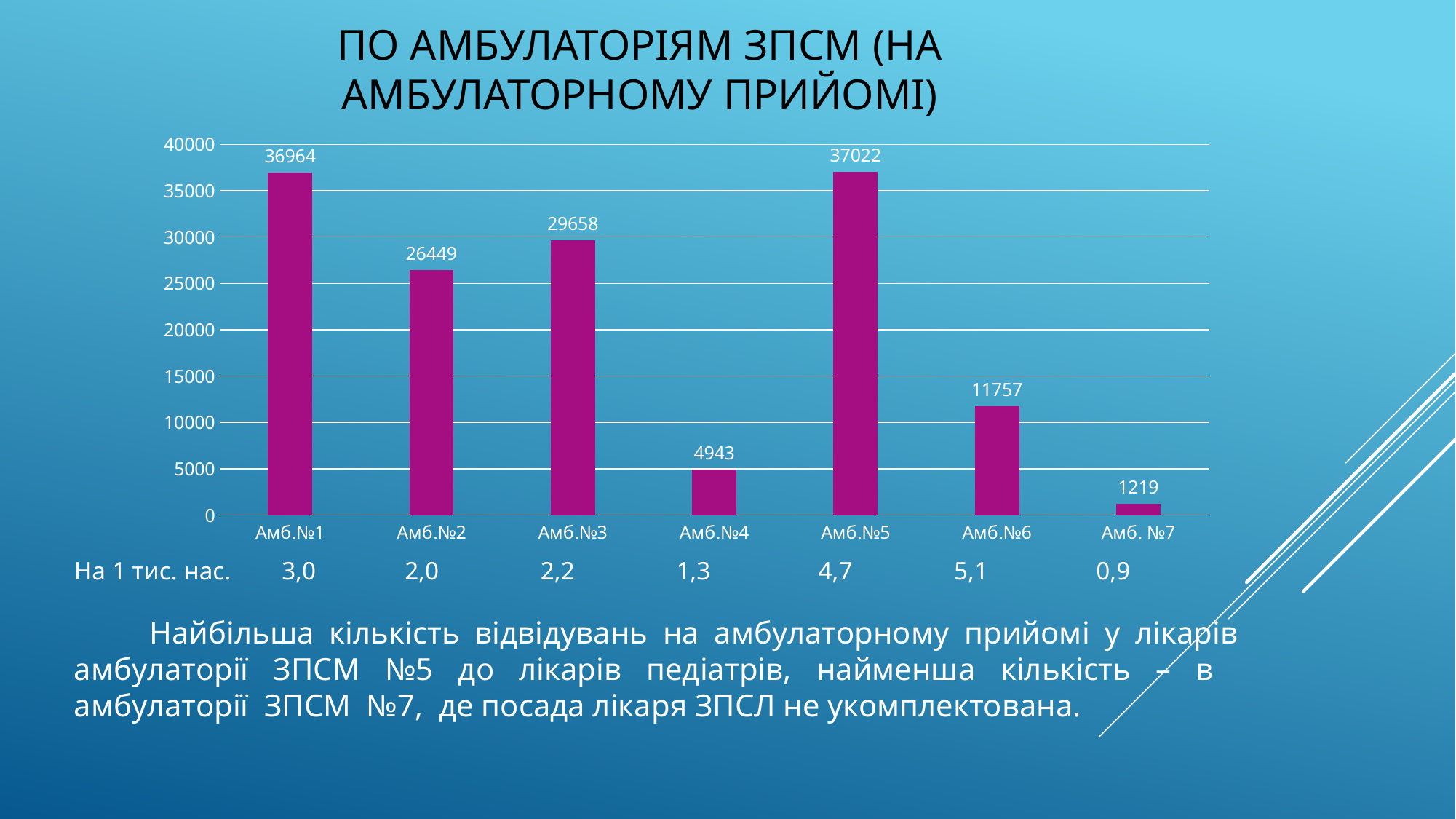
What is the difference between the values for Амб.№5 and Амб.№1? 58 What kind of chart is shown on the slide? bar chart What is the value for Амб.№4? 4943 Which is larger, the value for Амб.№3 or the value for Амб.№2? Амб.№3 What is the value for Амб.№6? 11757 What is the title of the chart? ПО АМБУЛАТОРІЯМ ЗПСМ (НА АМБУЛАТОРНОМУ ПРИЙОМІ) Which category has the highest value? Амб.№5 How many categories are shown on the x axis? 7 Which category has the lowest value? Амб. №7 What is the value for Амб.№1? 36964 Is the value for Амб.№6 greater or less than 10000? greater What is the difference between the values for Амб.№3 and Амб.№2? 3209